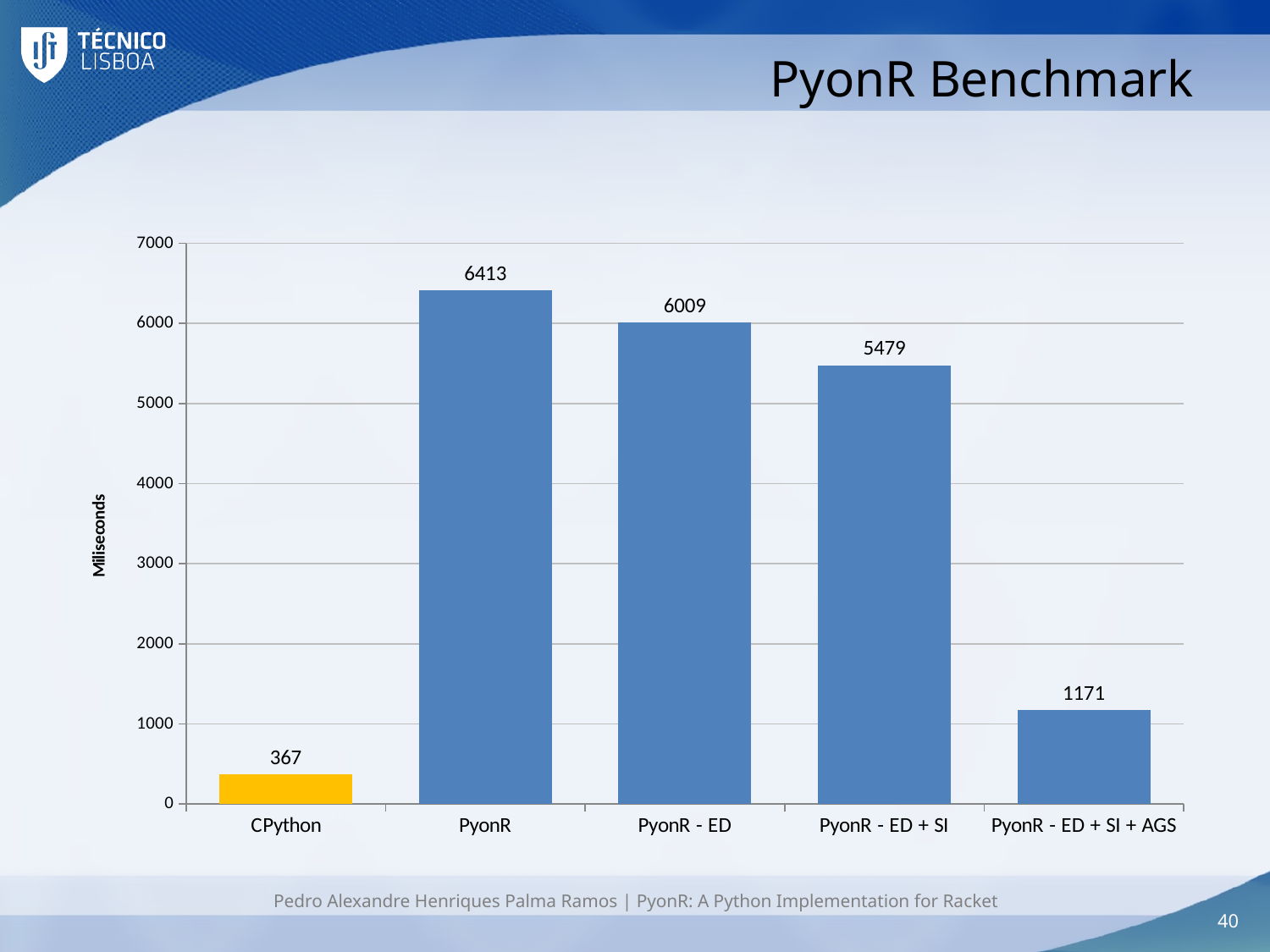
What is the value for PyonR - ED + SI + AGS? 1171 Which is larger, the value for PyonR - ED or the value for PyonR - ED + SI? PyonR - ED What is the value for CPython? 367 Is the value for PyonR - ED + SI greater or less than 5000? greater How many categories are shown on the x axis? 5 What is the value for PyonR - ED + SI? 5479 What is the difference between the values for PyonR - ED + SI + AGS and CPython? 804 What kind of chart is shown on the slide? bar chart What is the label of the y axis? Miliseconds Which category has the lowest value? CPython What is the difference between the values for PyonR and PyonR - ED? 404 Which category has the highest value? PyonR